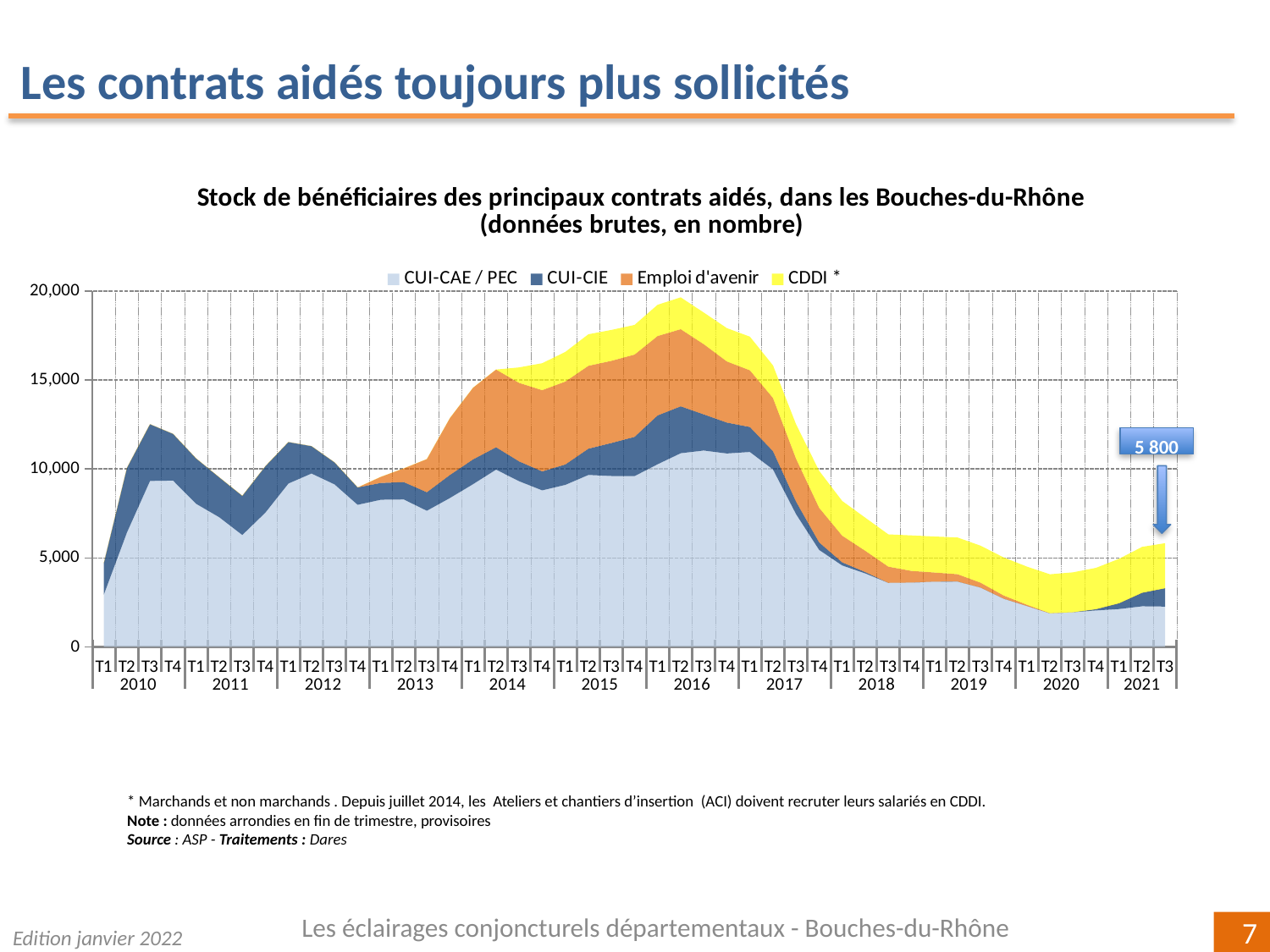
How many series does the legend of the chart list? 4 What is the title of the chart? Stock de bénéficiaires des principaux contrats aidés, dans les Bouches-du-Rhône (données brutes, en nombre) Is the total stock of beneficiaries in T1 2018 greater or less than 5,000? greater In which year does the total stock of beneficiaries reach its highest level? 2016 How many years are covered on the x axis of the chart? 12 Is the total stock of beneficiaries in T1 2017 greater or less than 10,000? greater Is the total stock of beneficiaries in T2 2016 greater or less than 15,000? greater What total value is annotated for T3 2021 in the chart? 5 800 Which series is shown in yellow in the chart? CDDI * What kind of chart is shown on the slide? Stacked area chart Does the total stock of beneficiaries rise or fall between 2017 and 2020? fall